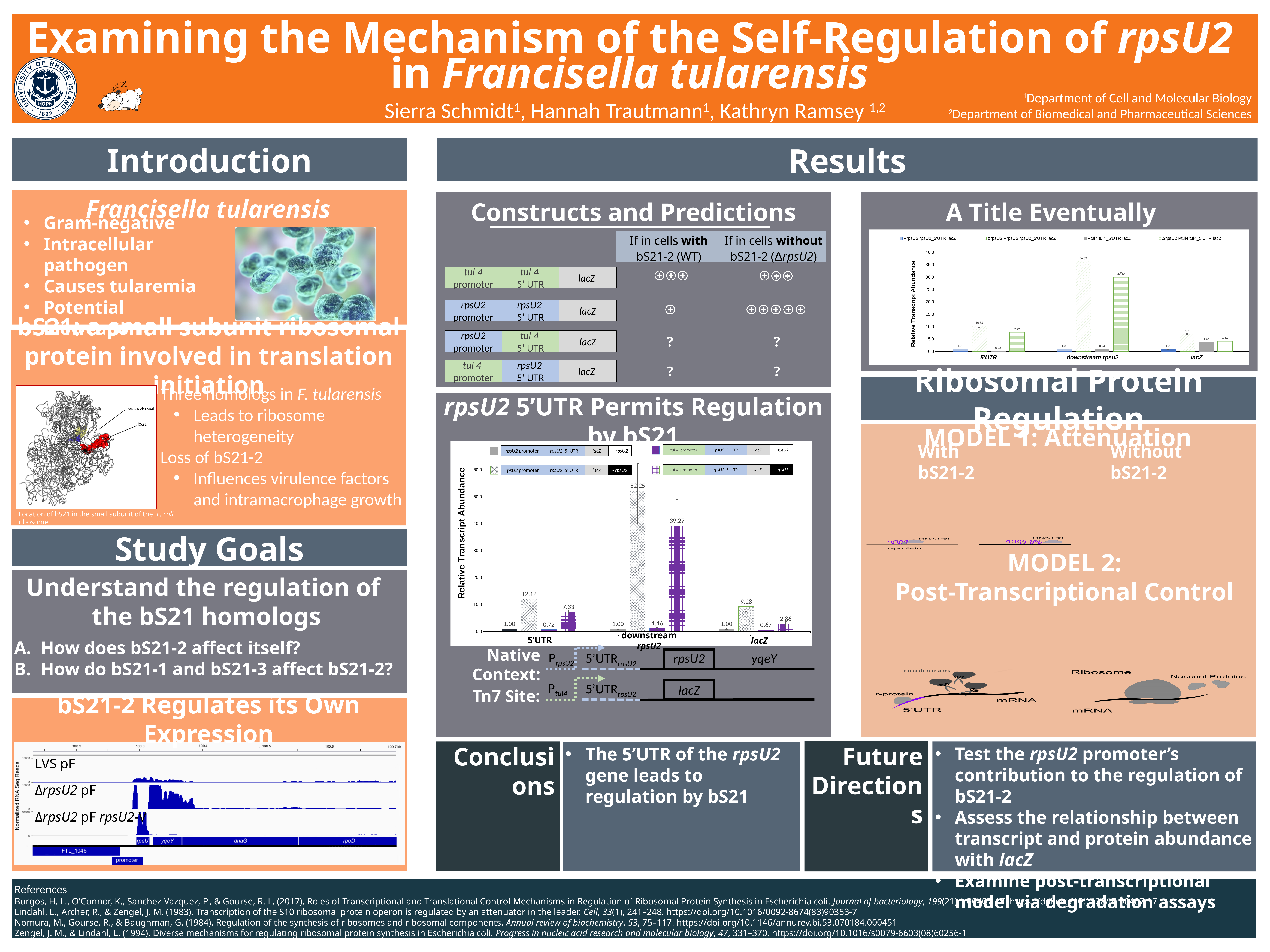
In the chart titled "rpsU2 5'UTR Permits Regulation by bS21", what is the highest value shown in the "5'UTR" category? 12.12 In the chart titled "rpsU2 5'UTR Permits Regulation by bS21", what is the highest value shown in the "downstream rpsU2" category? 52.25 In the chart titled "rpsU2 5'UTR Permits Regulation by bS21", how many categories are shown on the x axis? 3 In the chart titled "rpsU2 5'UTR Permits Regulation by bS21", what is the lowest value shown in the "lacZ" category? 0.67 In the chart titled "A Title Eventually", what is the highest value shown in the "downstream rpsu2" category? 36.33 In the chart titled "rpsU2 5'UTR Permits Regulation by bS21", how many series does the legend list? 4 In the chart titled "A Title Eventually", how many series does the legend list? 4 In the chart titled "rpsU2 5'UTR Permits Regulation by bS21", what is the difference between the two largest values in the "downstream rpsU2" category (52.25 and 39.27)? 12.98 In the chart titled "A Title Eventually", is the highest value in the "5'UTR" category greater or less than 20.0? less In the chart titled "rpsU2 5'UTR Permits Regulation by bS21", which is larger: the highest value in the "5'UTR" category or the highest value in the "lacZ" category? 5'UTR (12.12) In the chart titled "rpsU2 5'UTR Permits Regulation by bS21", what is the label of the y axis? Relative Transcript Abundance What kind of chart is the one titled "rpsU2 5'UTR Permits Regulation by bS21"? Bar chart